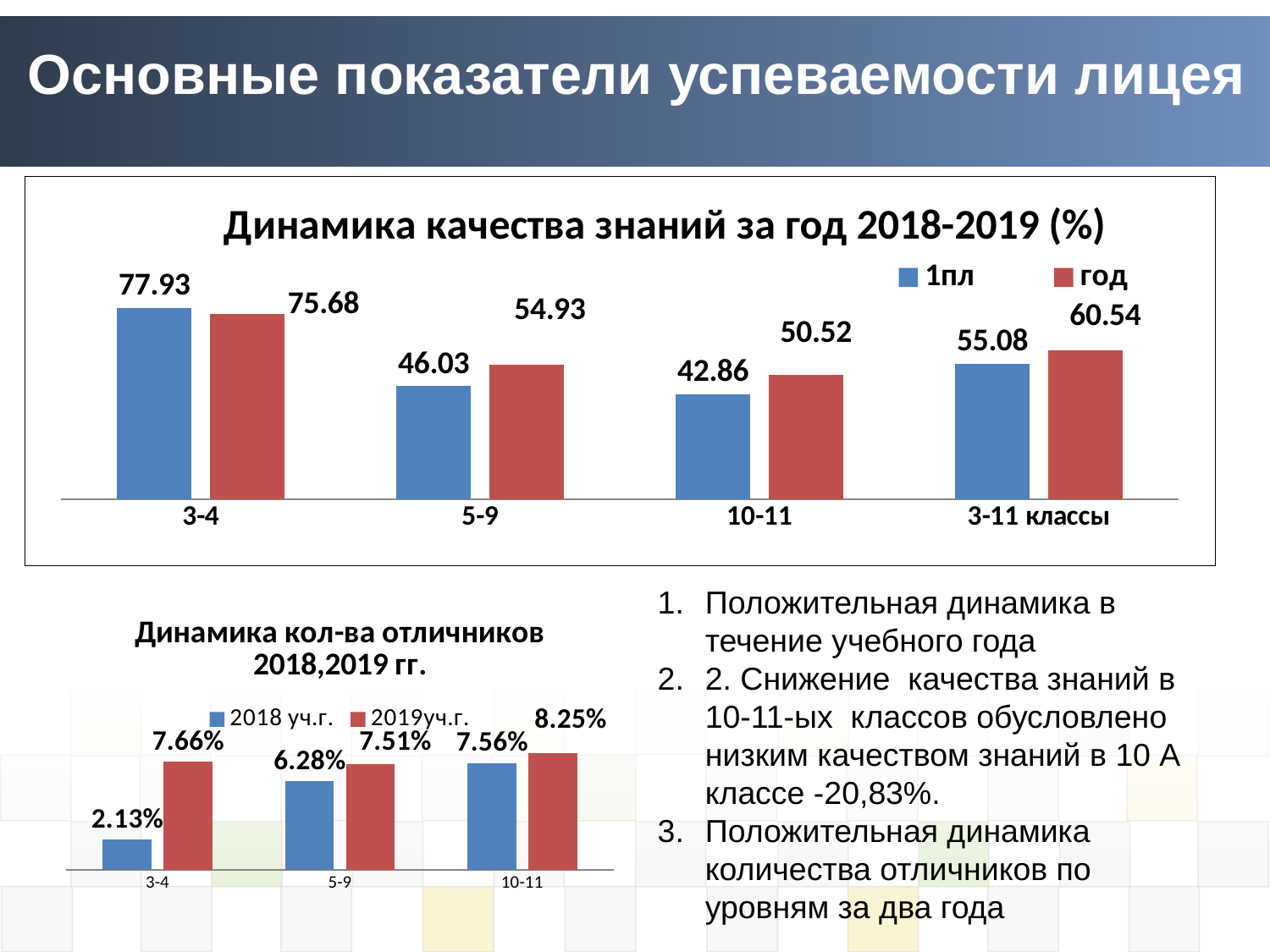
How many series does the legend of the chart 'Динамика качества знаний за год 2018-2019 (%)' list? 2 How many categories are shown on the x axis of the chart 'Динамика качества знаний за год 2018-2019 (%)'? 4 In the chart 'Динамика качества знаний за год 2018-2019 (%)', which is larger for '3-4': '1пл' or 'год'? 1пл In the chart 'Динамика качества знаний за год 2018-2019 (%)', what is the difference between the 'год' and '1пл' values for '5-9'? 8.90 In the chart 'Динамика качества знаний за год 2018-2019 (%)', what is the value of '1пл' for '3-4'? 77.93 In the chart 'Динамика кол-ва отличников 2018,2019 гг.', which category has the highest '2019уч.г.' value? 10-11 In the chart 'Динамика кол-ва отличников 2018,2019 гг.', what is the difference between the '2019уч.г.' and '2018 уч.г.' values for '3-4'? 5.53% In the chart 'Динамика кол-ва отличников 2018,2019 гг.', what is the value of '2018 уч.г.' for '3-4'? 2.13% In the chart 'Динамика качества знаний за год 2018-2019 (%)', what is the value of 'год' for '10-11'? 50.52 In the chart 'Динамика качества знаний за год 2018-2019 (%)', which category has the highest 'год' value? 3-4 In the chart 'Динамика качества знаний за год 2018-2019 (%)', which category has the lowest '1пл' value? 10-11 What type of chart is 'Динамика кол-ва отличников 2018,2019 гг.'? Bar chart